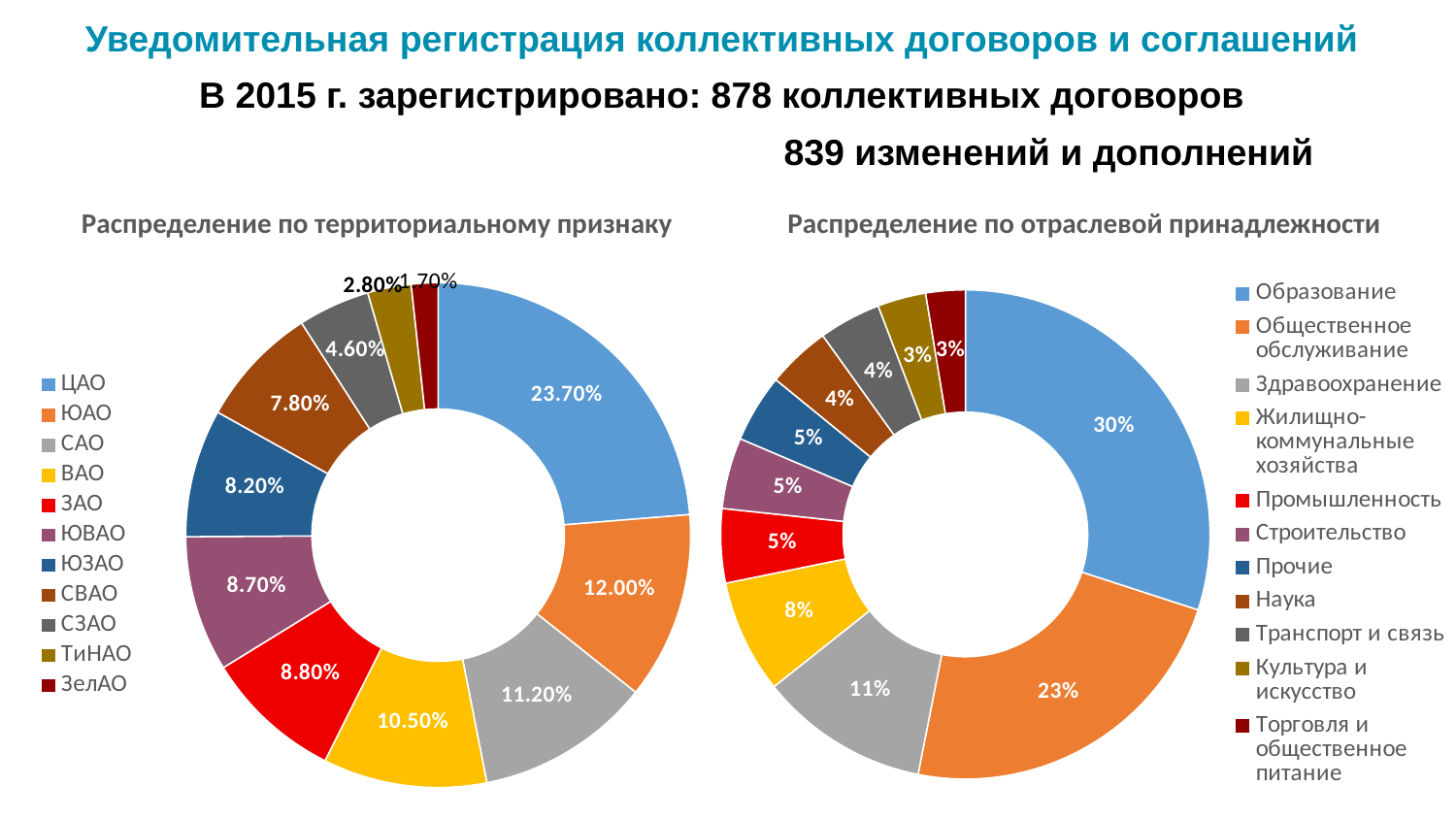
In the chart 'Распределение по отраслевой принадлежности', what is the value for Образование? 30% In the chart 'Распределение по отраслевой принадлежности', what colour is the slice for Промышленность? Red In the chart 'Распределение по территориальному признаку', what is the value for ЮЗАО? 8.20% In the chart 'Распределение по территориальному признаку', which category has the lowest value? ЗелАО In the chart 'Распределение по территориальному признаку', how many categories are shown in the legend? 11 In the chart 'Распределение по отраслевой принадлежности', which category has the highest value? Образование In the chart 'Распределение по территориальному признаку', what is the value for ЦАО? 23.70% In the chart 'Распределение по отраслевой принадлежности', what is the value for Здравоохранение? 11% In the chart 'Распределение по территориальному признаку', which is larger, the value for ВАО or the value for СВАО? ВАО In the chart 'Распределение по отраслевой принадлежности', what is the difference between the values for Образование and Общественное обслуживание? 7% In the chart 'Распределение по территориальному признаку', what is the difference between the values for ЮАО and САО? 0.80% What kind of chart is 'Распределение по отраслевой принадлежности'? Pie (doughnut) chart